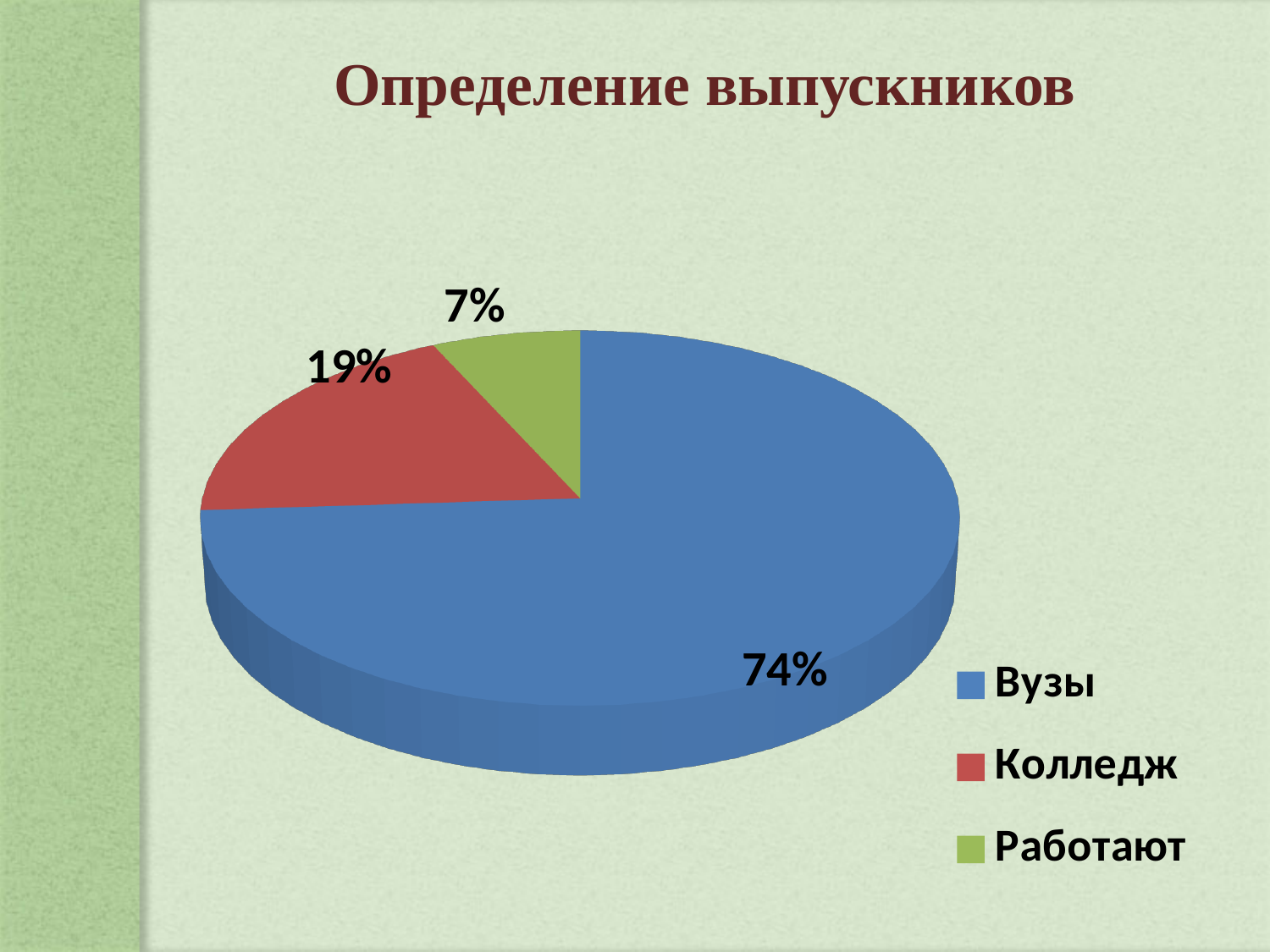
What is the difference in percentage points between Вузы and Колледж? 55 What share of the pie does Колледж take? 19% What colour is the slice for Работают? Green What is the difference in percentage points between Колледж and Работают? 12 What kind of chart is shown on the slide? Pie chart What share of the pie does Работают take? 7% Which category has the largest slice? Вузы Which is larger, the share for Колледж or the share for Работают? Колледж What share of the pie does Вузы take? 74% How many slices does the pie chart have? 3 Which category has the smallest slice? Работают What is the title of the chart? Определение выпускников